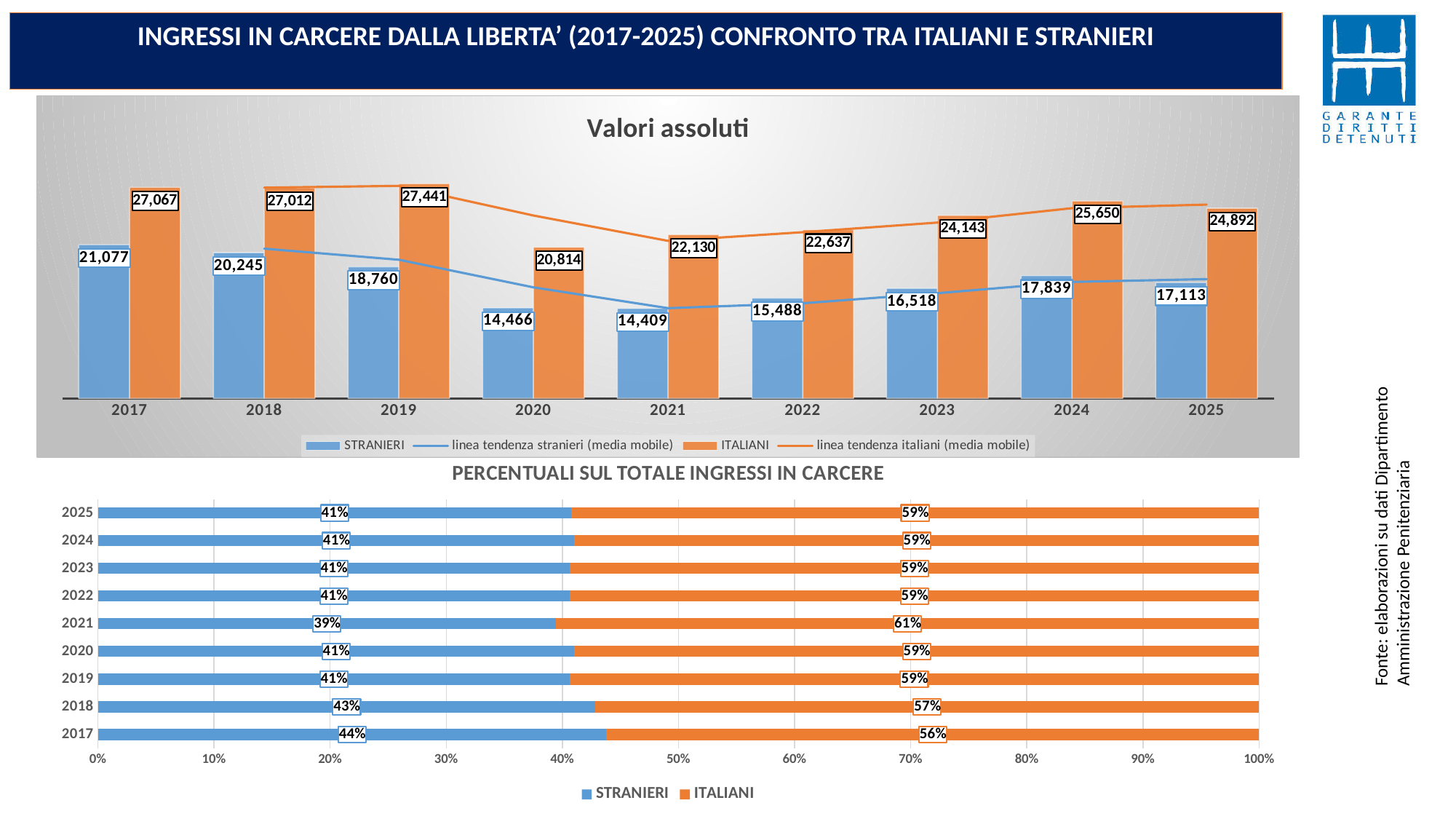
In the 'PERCENTUALI SUL TOTALE INGRESSI IN CARCERE' chart, what is the share of STRANIERI in 2017? 44% What kind of chart is the 'PERCENTUALI SUL TOTALE INGRESSI IN CARCERE' chart? Stacked bar chart In the 'Valori assoluti' chart, which year has the lowest value for STRANIERI? 2021 In the 'Valori assoluti' chart, how many entries does the legend list? 4 In the 'Valori assoluti' chart, what is the value for ITALIANI in 2019? 27,441 In the 'PERCENTUALI SUL TOTALE INGRESSI IN CARCERE' chart, what is the share of ITALIANI in 2021? 61% In the 'Valori assoluti' chart, which is larger in 2020: STRANIERI or ITALIANI? ITALIANI In the 'Valori assoluti' chart, which year has the highest value for ITALIANI? 2019 In the 'Valori assoluti' chart, what is the value for STRANIERI in 2021? 14,409 In the 'Valori assoluti' chart, how many years are shown on the x axis? 9 In the 'PERCENTUALI SUL TOTALE INGRESSI IN CARCERE' chart, which year has the lowest share of STRANIERI? 2021 In the 'Valori assoluti' chart, what is the difference between ITALIANI and STRANIERI in 2025? 7,779